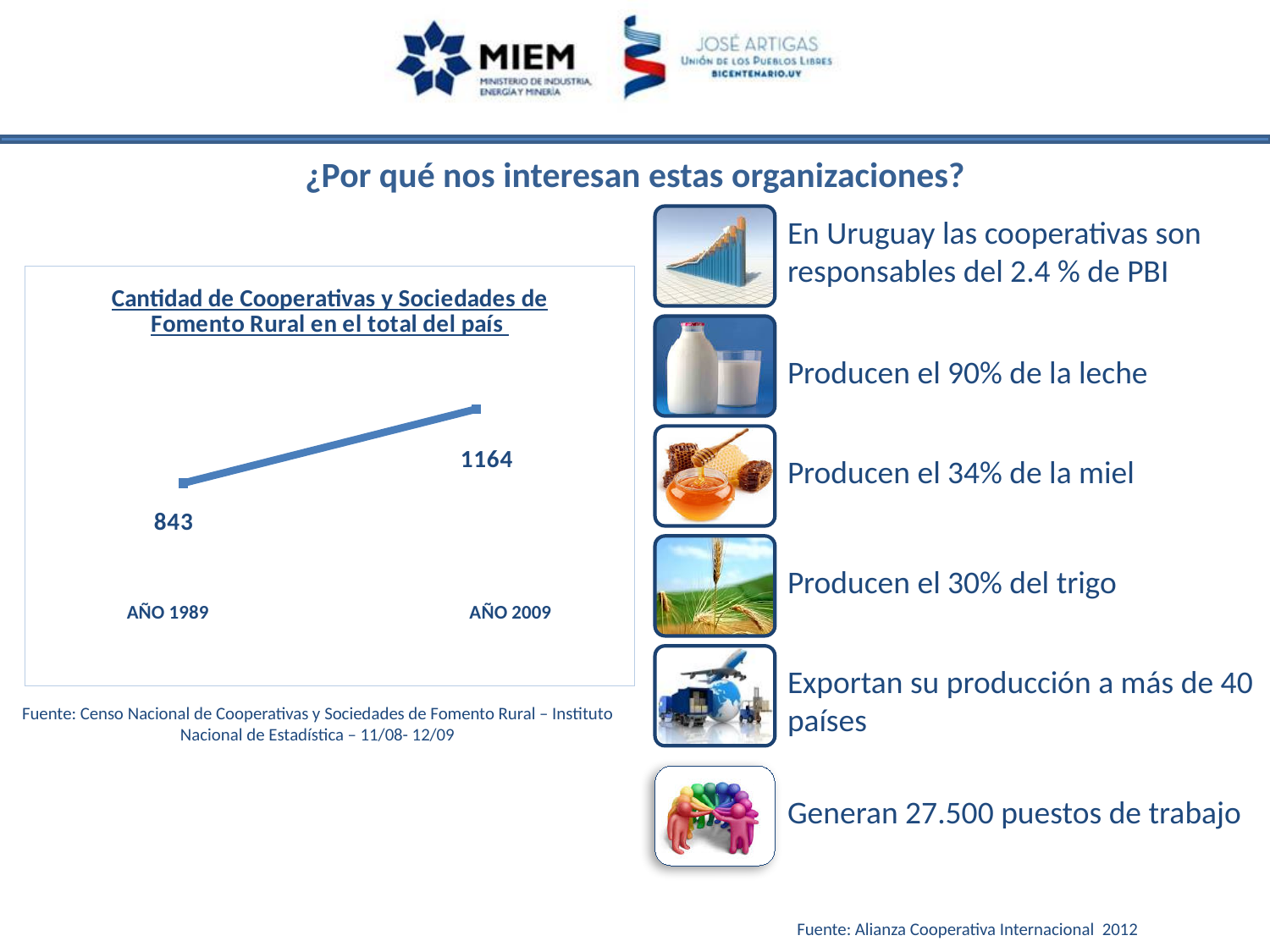
What kind of chart is shown on the slide? line chart What colour is the line in the chart? blue Which year has the lower value in the chart? AÑO 1989 What is the value for AÑO 2009 in the chart? 1164 What is the difference between the values for AÑO 2009 and AÑO 1989? 321 Which year has the higher value in the chart? AÑO 2009 How many data points are plotted in the chart? 2 What is the title of the chart? Cantidad de Cooperativas y Sociedades de Fomento Rural en el total del país Is the value for AÑO 2009 larger or smaller than the value for AÑO 1989? larger What is the value for AÑO 1989 in the chart? 843 Does the value rise or fall from AÑO 1989 to AÑO 2009? rise